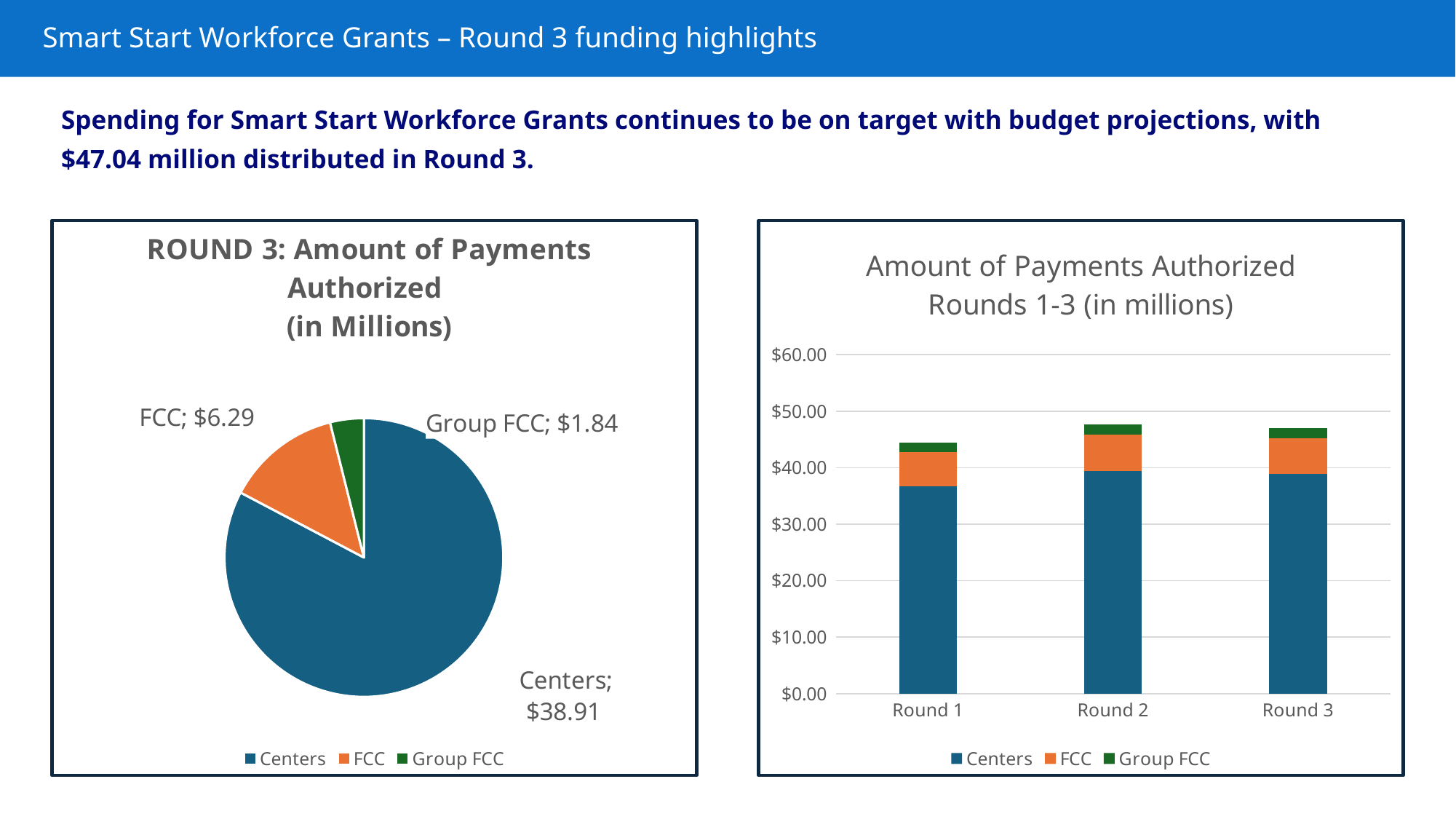
In the chart 'Amount of Payments Authorized Rounds 1-3 (in millions)', is the total for Round 2 greater or less than $50.00? less What kind of chart is 'Amount of Payments Authorized Rounds 1-3 (in millions)'? Stacked bar chart In the pie chart 'ROUND 3: Amount of Payments Authorized (in Millions)', what is the value for Group FCC? $1.84 How many rounds are shown on the x axis of the chart 'Amount of Payments Authorized Rounds 1-3 (in millions)'? 3 In the pie chart 'ROUND 3: Amount of Payments Authorized (in Millions)', what is the difference between the Centers value and the FCC value? $32.62 In the pie chart 'ROUND 3: Amount of Payments Authorized (in Millions)', which category has the smallest slice? Group FCC In the pie chart 'ROUND 3: Amount of Payments Authorized (in Millions)', what is the value for FCC? $6.29 In the pie chart 'ROUND 3: Amount of Payments Authorized (in Millions)', what is the value for Centers? $38.91 How many series does the legend of the chart 'Amount of Payments Authorized Rounds 1-3 (in millions)' list? 3 In the pie chart 'ROUND 3: Amount of Payments Authorized (in Millions)', what is the total of all three slices? $47.04 In the pie chart 'ROUND 3: Amount of Payments Authorized (in Millions)', what share of the total does Centers represent, to one decimal place? 82.7% In the chart 'Amount of Payments Authorized Rounds 1-3 (in millions)', which is larger, the total bar for Round 1 or the total bar for Round 2? Round 2